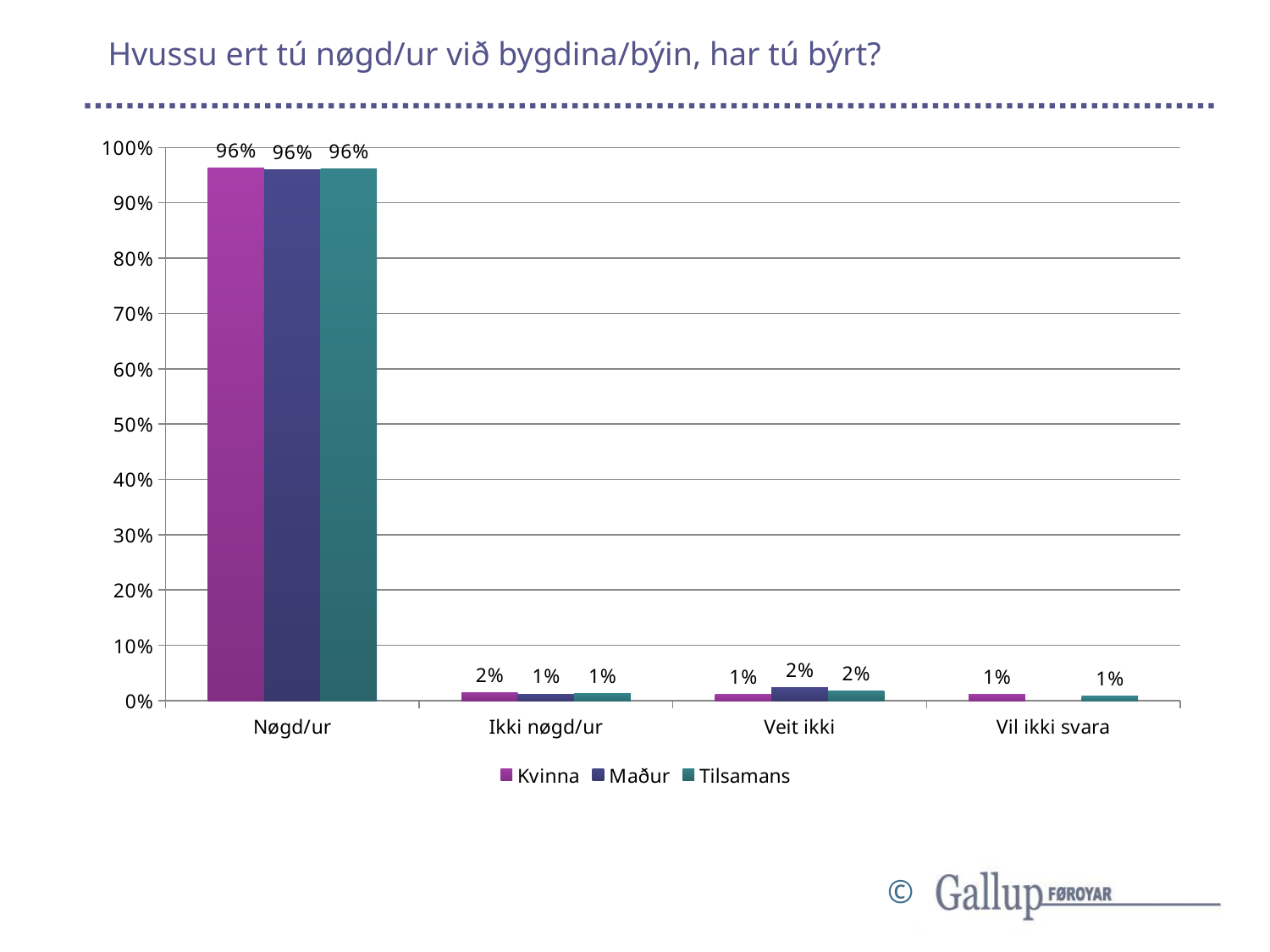
What is the value for Maður in the Veit ikki category? 2% How many categories are shown on the x axis? 4 Which series is shown in the pink/magenta colour? Kvinna Which category has the highest value for Tilsamans? Nøgd/ur What is the value for Kvinna in the Nøgd/ur category? 96% Which is larger: the Kvinna value for Ikki nøgd/ur or the Maður value for Ikki nøgd/ur? Kvinna What is the value for Tilsamans in the Vil ikki svara category? 1% What is the value for Kvinna in the Ikki nøgd/ur category? 2% How many series does the legend list? 3 Is the value for Tilsamans in the Nøgd/ur category greater or less than 90%? greater What kind of chart is shown on the slide? bar chart What is the difference between the Kvinna value for Nøgd/ur and the Kvinna value for Ikki nøgd/ur? 94%